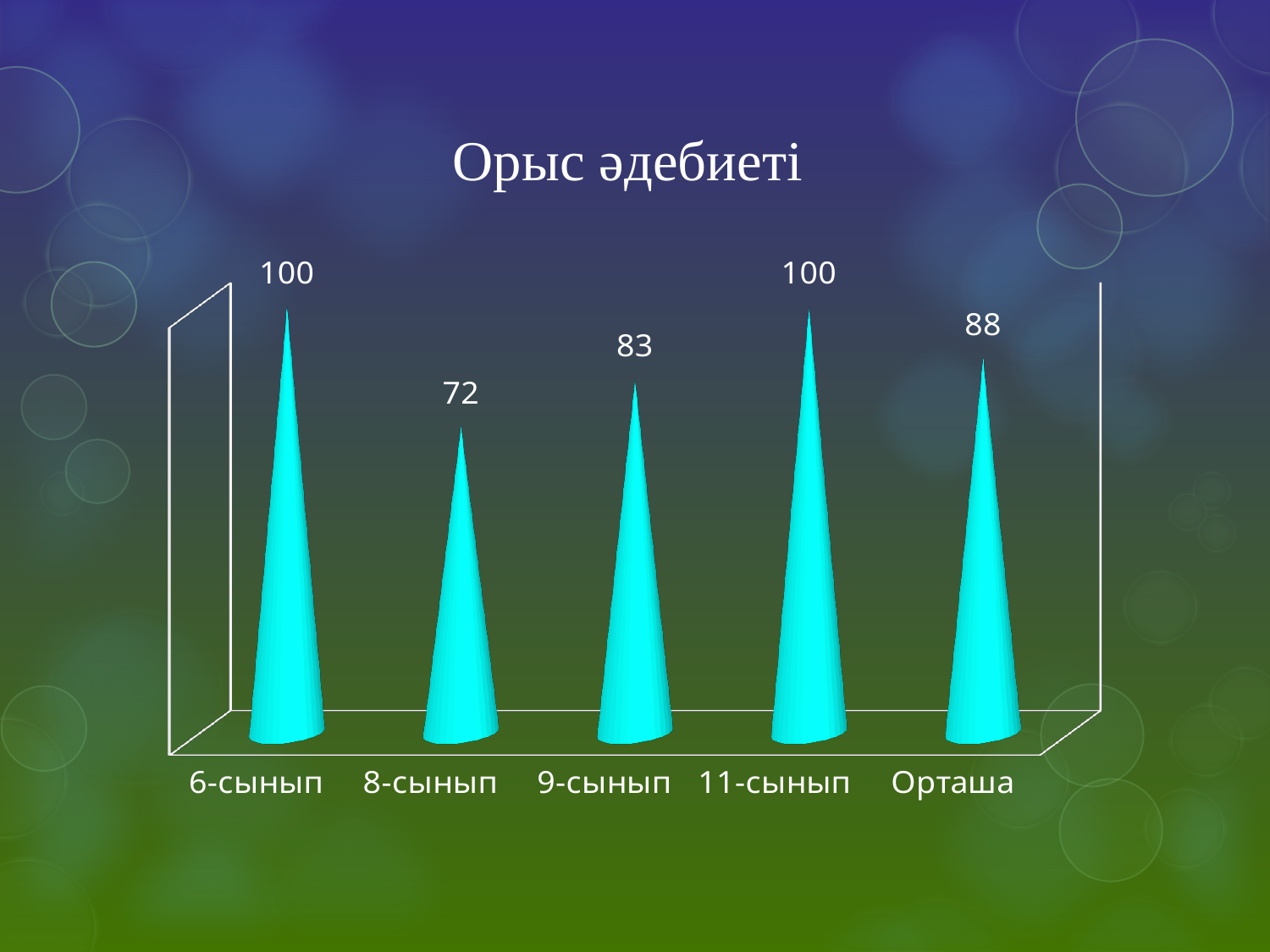
What is the difference between the values for 11-сынып and Орташа? 12 What is the value for 8-сынып? 72 What kind of chart is shown on the slide? bar chart What is the value for 6-сынып? 100 Which two categories share the highest value of 100? 6-сынып and 11-сынып Which category has the lowest value? 8-сынып Which is larger, the value for 9-сынып or the value for Орташа? Орташа What is the difference between the values for 9-сынып and 8-сынып? 11 What is the value for 9-сынып? 83 What is the value for Орташа? 88 What is the title of the chart? Орыс әдебиеті How many categories are shown on the x axis? 5